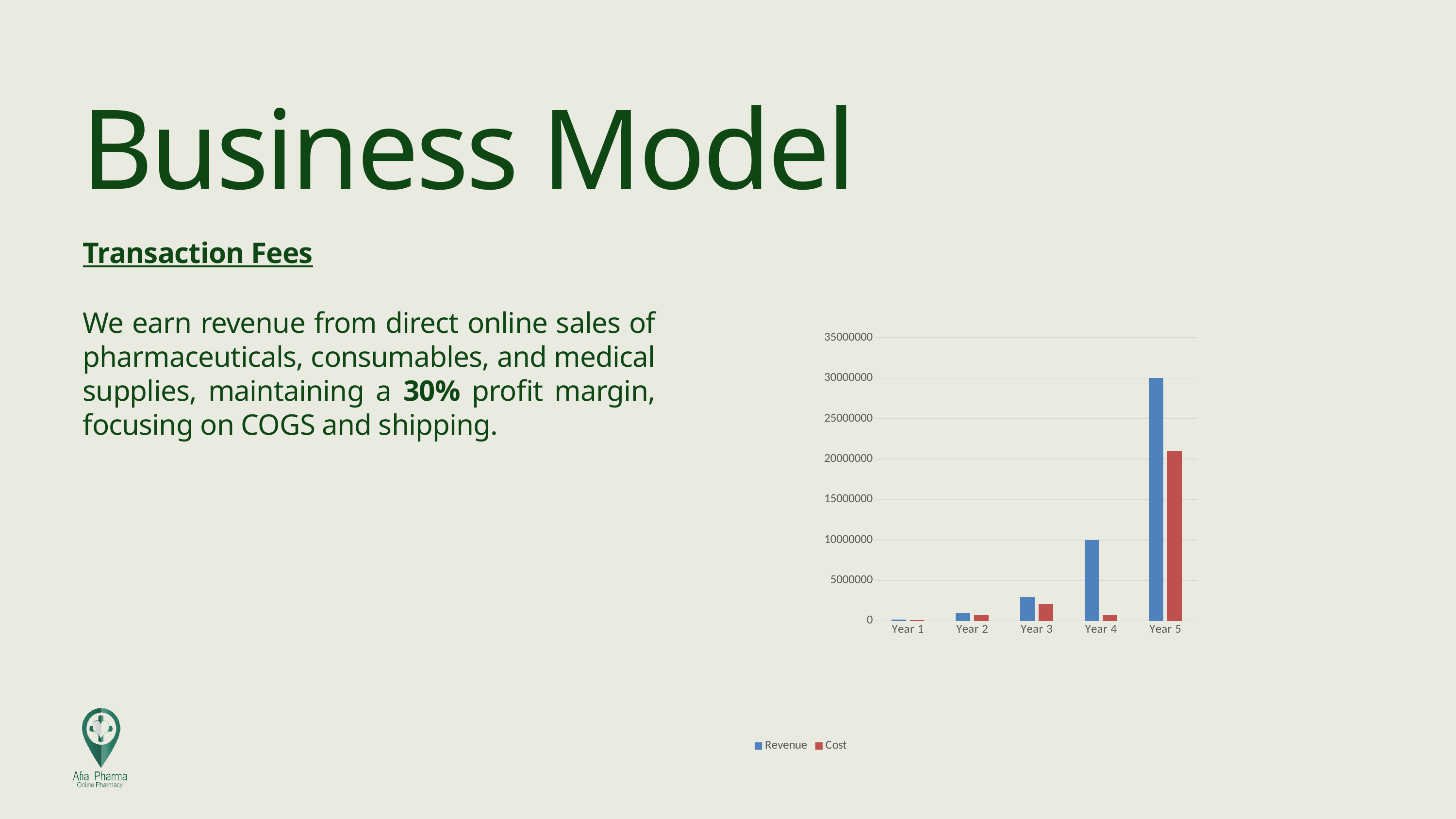
Which year has the highest Revenue in the chart? Year 5 Does Revenue rise or fall from Year 1 to Year 5? rise What is the Revenue value for Year 4? 10000000 Is the Cost value for Year 4 greater or less than 5000000? less What kind of chart is shown on the slide? bar chart Is the Revenue value for Year 3 greater or less than 5000000? less Is the Cost value for Year 5 greater or less than 20000000? greater How many years are shown on the x axis of the chart? 5 What is the Revenue value for Year 5? 30000000 How many series does the chart's legend list? 2 Which year has the lowest Revenue in the chart? Year 1 In Year 5, which is larger, Revenue or Cost? Revenue